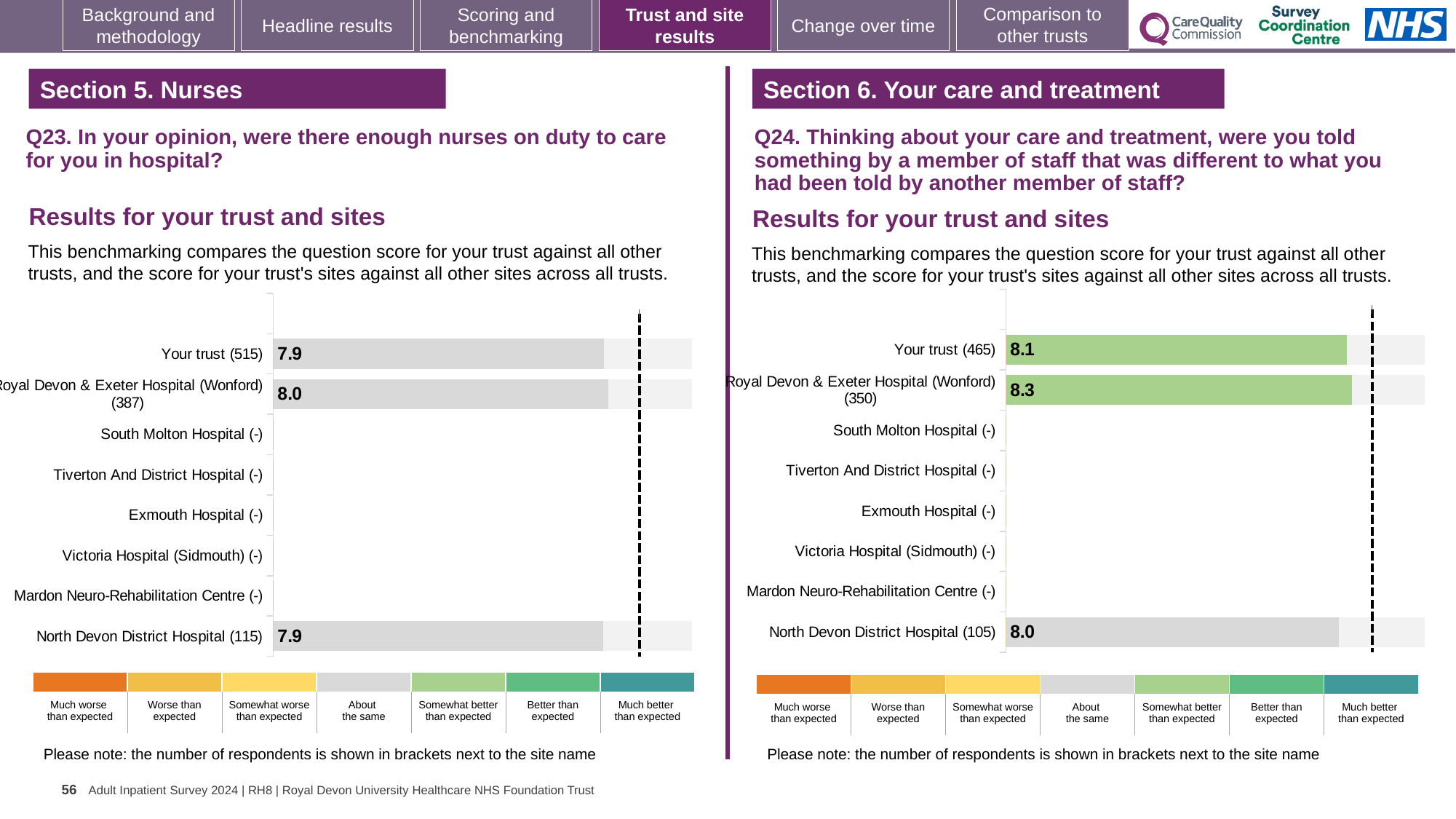
On the Q23 chart (left), how many respondents are shown in brackets for Your trust? 515 On the Q23 chart (left), which has the larger score: Royal Devon & Exeter Hospital (Wonford) or North Devon District Hospital? Royal Devon & Exeter Hospital (Wonford) What type of chart is used on the Q23 chart (left)? Bar chart On the Q24 chart (right), how many respondents are shown in brackets for North Devon District Hospital? 105 On the Q23 chart (left), what is the score for Your trust? 7.9 On the Q24 chart (right), what is the difference between the score for Royal Devon & Exeter Hospital (Wonford) and the score for North Devon District Hospital? 0.3 On the Q24 chart (right), what is the score for Royal Devon & Exeter Hospital (Wonford)? 8.3 On the Q23 chart (left), what is the score for Royal Devon & Exeter Hospital (Wonford)? 8.0 On the Q23 chart (left), what is the score for North Devon District Hospital? 7.9 On the Q24 chart (right), what is the score for Your trust? 8.1 On the Q24 chart (right), which site or trust row has the highest score? Royal Devon & Exeter Hospital (Wonford) On the Q24 chart (right), what is the score for North Devon District Hospital? 8.0